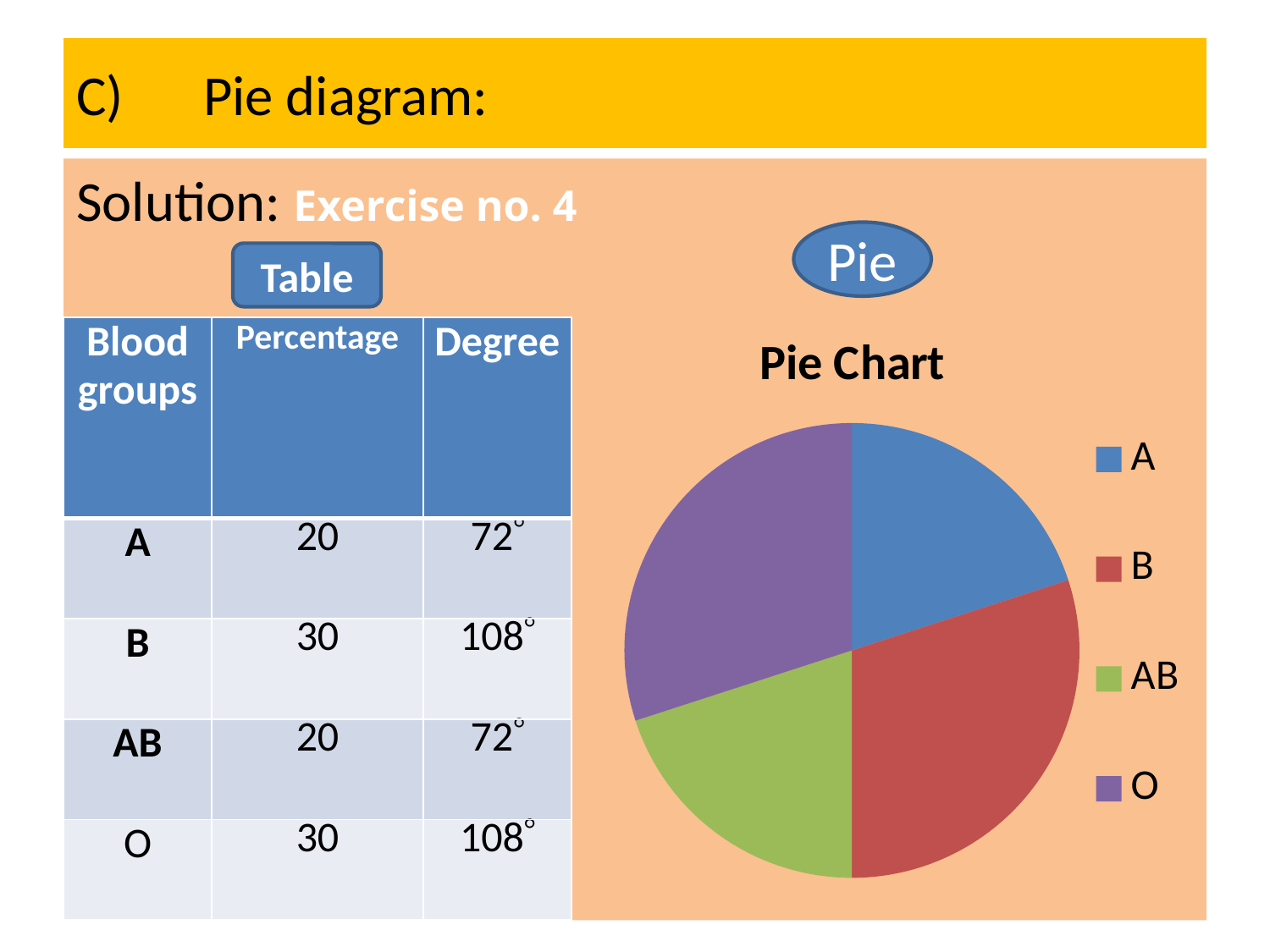
Which colour represents blood group O in the pie chart? purple What is the title of the chart? Pie Chart How many entries does the chart legend list? 4 According to the table on the slide, what is the degree value for blood group O? 108° Is the slice for blood group B larger or smaller than the slice for blood group A? larger What type of chart is shown on the slide? pie chart Is the slice for blood group AB larger or smaller than the slice for blood group O? smaller What share of the pie does blood group AB represent, according to the table? 20% According to the table on the slide, what percentage does blood group B have? 30 According to the table on the slide, what is the degree value for blood group A? 72° How many slices does the pie chart have? 4 What is the difference in percentage between blood group O and blood group A, according to the table? 10